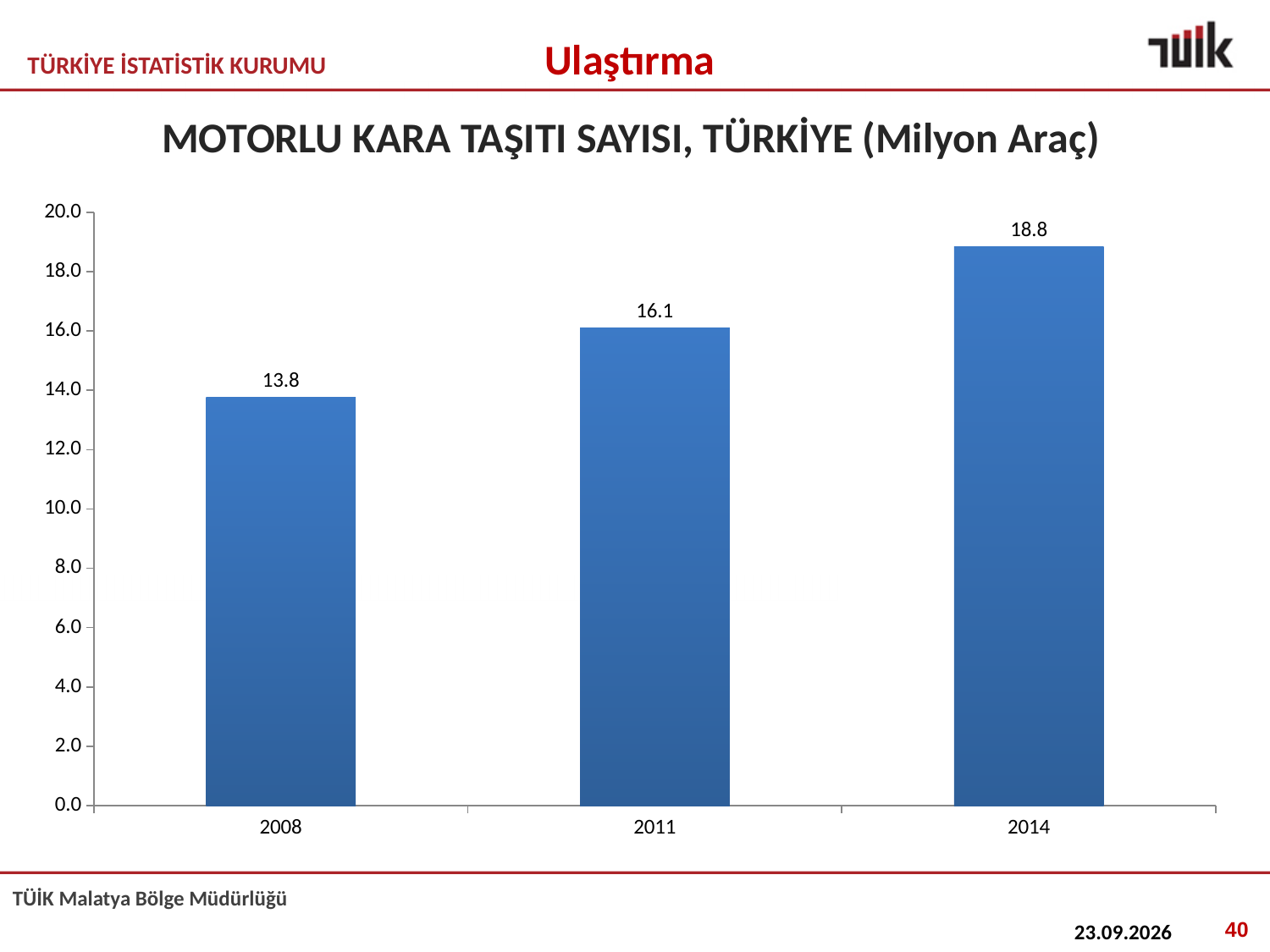
Do the values rise or fall from 2008 to 2014? rise Which is larger, the value for 2011 or the value for 2014? 2014 Which year has the lowest value? 2008 What is the value for 2008? 13.8 What is the difference between the values for 2014 and 2008? 5.0 What is the value for 2014? 18.8 Which year has the highest value? 2014 How many years are shown on the x axis? 3 What is the value for 2011? 16.1 What kind of chart is shown on the slide? bar chart Is the value for 2011 greater or less than 14.0? greater What is the difference between the values for 2011 and 2008? 2.3